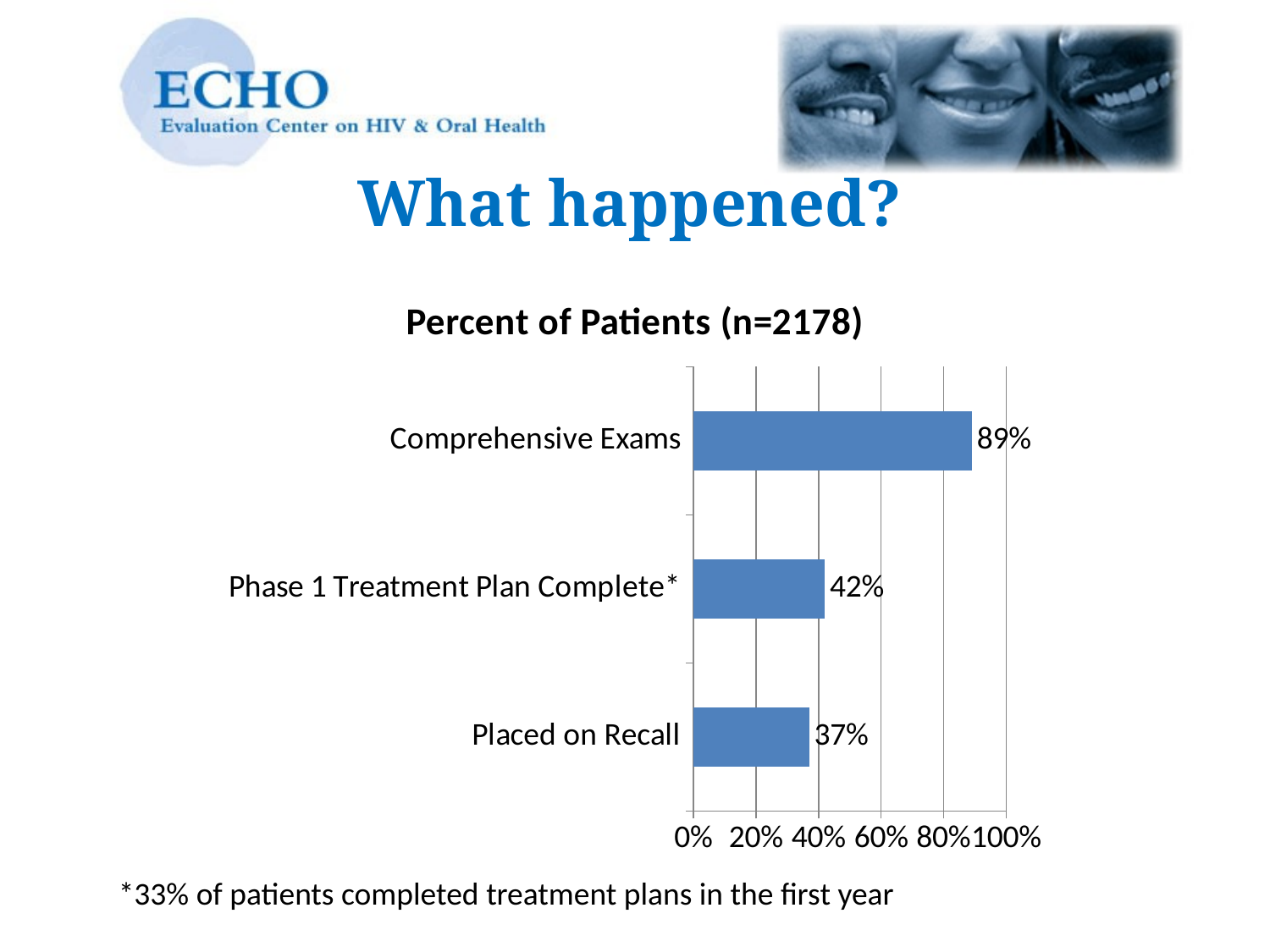
What is the value for Phase 1 Treatment Plan Complete*? 42% What is the value for Placed on Recall? 37% What is the value for Comprehensive Exams? 89% Which is larger, the value for Phase 1 Treatment Plan Complete* or the value for Placed on Recall? Phase 1 Treatment Plan Complete* What is the difference between the values for Phase 1 Treatment Plan Complete* and Placed on Recall? 5% What is the title of the chart? Percent of Patients (n=2178) Which category has the lowest value? Placed on Recall Which category has the highest value? Comprehensive Exams What is the difference between the values for Comprehensive Exams and Placed on Recall? 52% Is the value for Comprehensive Exams greater or less than 80%? greater What kind of chart is shown on the slide? bar chart How many categories are shown in the chart? 3